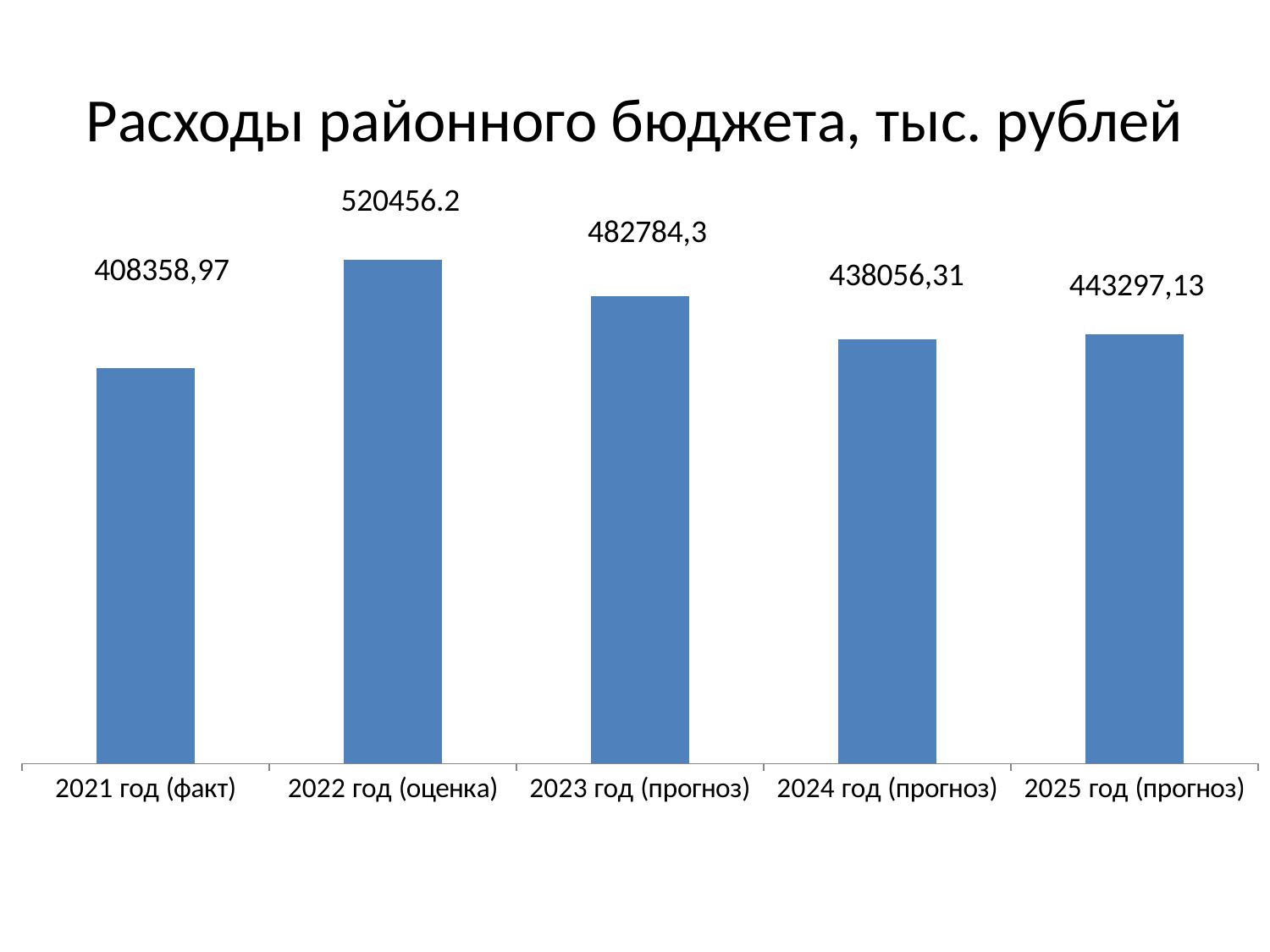
What is the value for 2025 год (прогноз)? 443297,13 What is the value for 2023 год (прогноз)? 482784,3 What is the value for 2021 год (факт)? 408358,97 Which category has the highest value? 2022 год (оценка) Which is larger, the value for 2024 год (прогноз) or 2025 год (прогноз)? 2025 год (прогноз) What is the value for 2024 год (прогноз)? 438056,31 Which category has the lowest value? 2021 год (факт) What is the value for 2022 год (оценка)? 520456.2 What kind of chart is shown on the slide? bar chart How many categories are shown on the chart? 5 What is the difference between the values for 2023 год (прогноз) and 2024 год (прогноз)? 44727,99 What is the title of the chart? Расходы районного бюджета, тыс. рублей